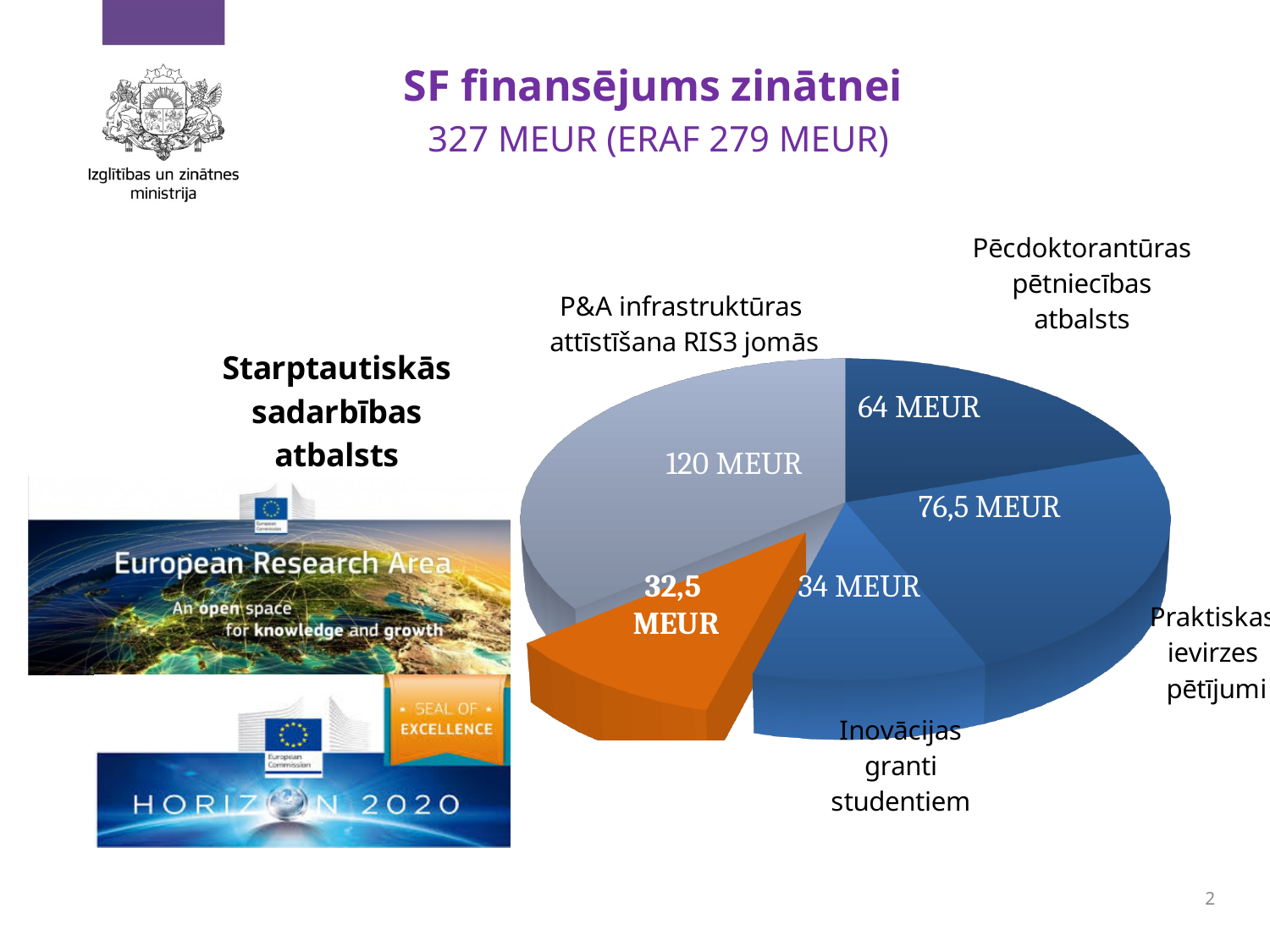
What is the value for Starptautiskās sadarbības atbalsts? 32,5 MEUR What is the value for Inovācijas granti studentiem? 34 MEUR How many slices does the pie chart have? 5 What is the value for P&A infrastruktūras attīstīšana RIS3 jomās? 120 MEUR What is the value for Pēcdoktorantūras pētniecības atbalsts? 64 MEUR Which category has the largest slice of the pie? P&A infrastruktūras attīstīšana RIS3 jomās What is the difference between the values for P&A infrastruktūras attīstīšana RIS3 jomās and Praktiskas ievirzes pētījumi? 43,5 MEUR What type of chart is shown on the slide? pie chart Which slice of the pie chart is coloured orange and pulled out from the rest? Starptautiskās sadarbības atbalsts Which category has the smallest slice of the pie? Starptautiskās sadarbības atbalsts What is the value for Praktiskas ievirzes pētījumi? 76,5 MEUR Which is larger, the value for Inovācijas granti studentiem or the value for Starptautiskās sadarbības atbalsts? Inovācijas granti studentiem